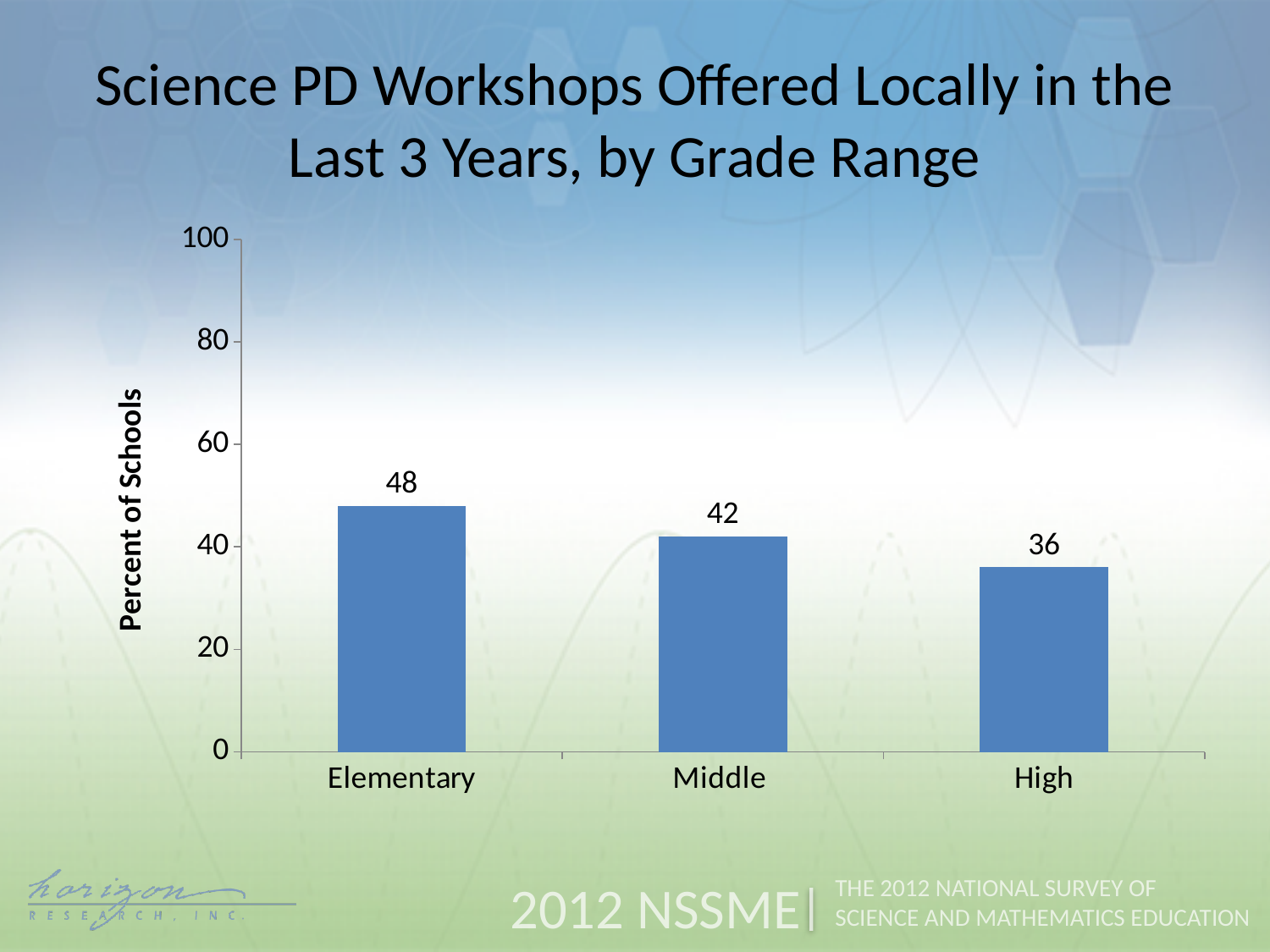
What is the difference between the values for Middle and High? 6 Which is larger, the value for Elementary or the value for Middle? Elementary What kind of chart is shown on the slide? bar chart Which grade range has the lowest percent of schools? High Which grade range has the highest percent of schools? Elementary How many grade ranges are shown on the chart? 3 What is the difference between the values for Elementary and High? 12 What is the value for High? 36 Is the value for High greater or less than 40? less What is the value for Elementary? 48 What is the value for Middle? 42 Do the values rise or fall from Elementary to High along the x axis? fall